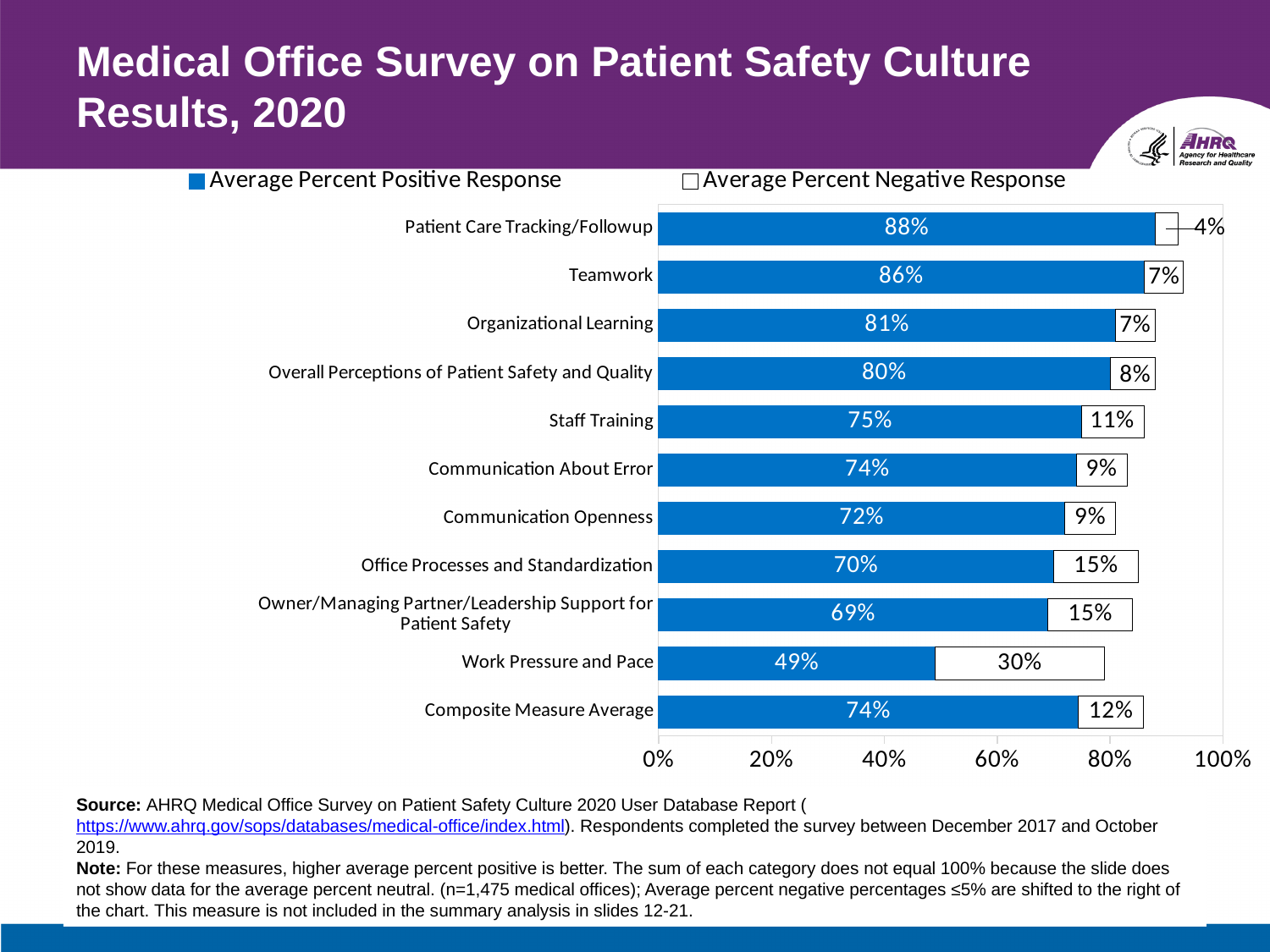
What is the difference between the Average Percent Positive Response for Staff Training and for Communication Openness? 3% Is the Average Percent Positive Response for Organizational Learning greater or less than 80%? greater How many categories are shown on the chart? 11 What is the Average Percent Positive Response for the Composite Measure Average? 74% What is the Average Percent Positive Response for Teamwork? 86% How many series does the legend list? 2 Which category has the lowest Average Percent Positive Response? Work Pressure and Pace What is the total of the positive and negative responses for Work Pressure and Pace? 79% What is the Average Percent Negative Response for Work Pressure and Pace? 30% Which has a larger Average Percent Negative Response, Office Processes and Standardization or Communication About Error? Office Processes and Standardization What kind of chart is shown on the slide? Bar chart Which category has the highest Average Percent Positive Response? Patient Care Tracking/Followup